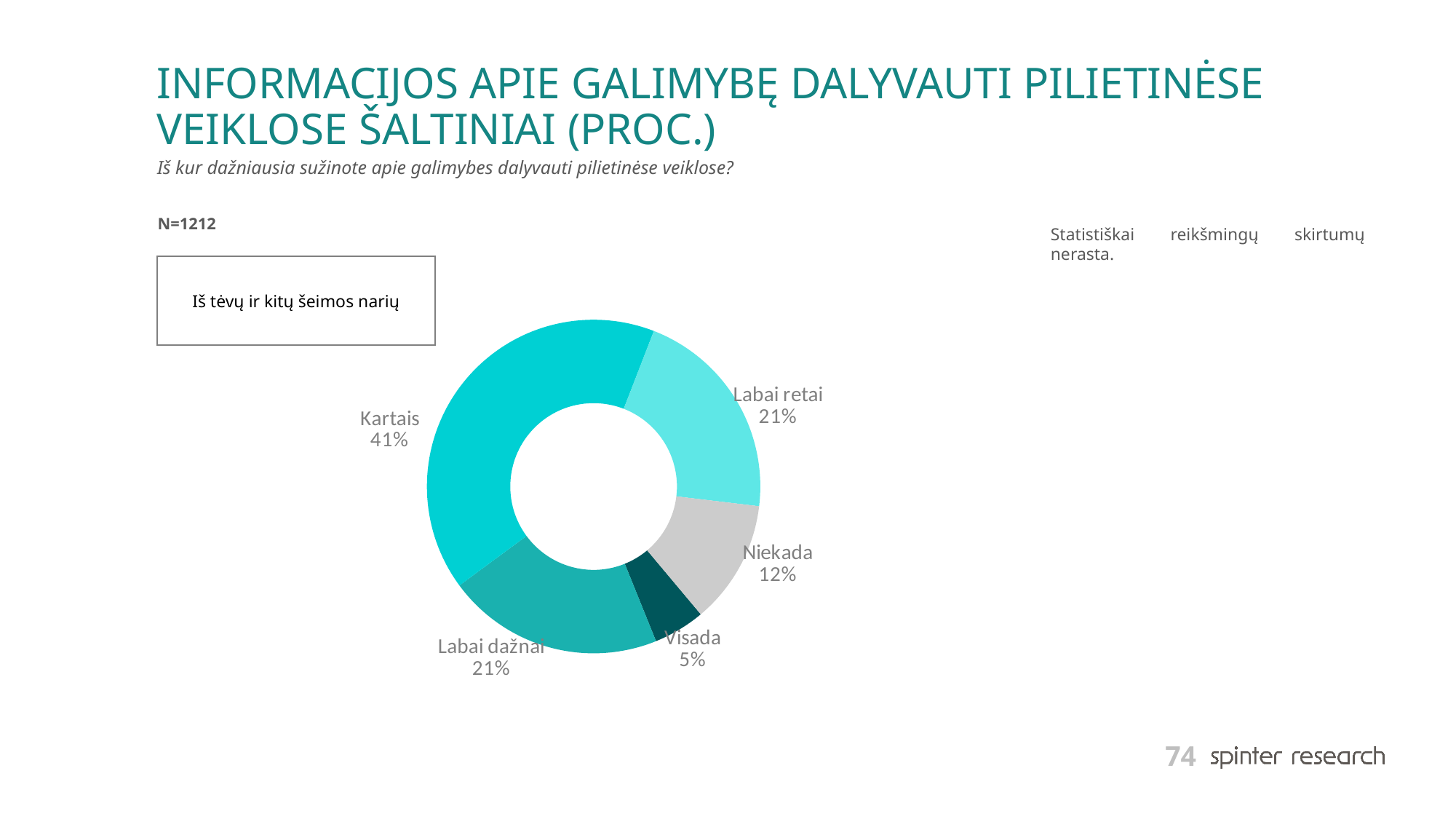
How many categories are shown in the chart? 5 What kind of chart is shown on the slide? Pie chart (doughnut) What percentage of respondents answered "Labai retai"? 21% What is the combined share of "Labai dažnai" and "Visada"? 26% What percentage of respondents answered "Visada"? 5% Which category has the largest share of the chart? Kartais What is the sample size (N) shown on the slide? N=1212 What percentage of respondents answered "Niekada"? 12% What percentage of respondents answered "Kartais"? 41% Which category has the smallest share of the chart? Visada What is the difference in percentage points between "Kartais" and "Labai dažnai"? 20 Which is larger, the share for "Niekada" or the share for "Visada"? Niekada